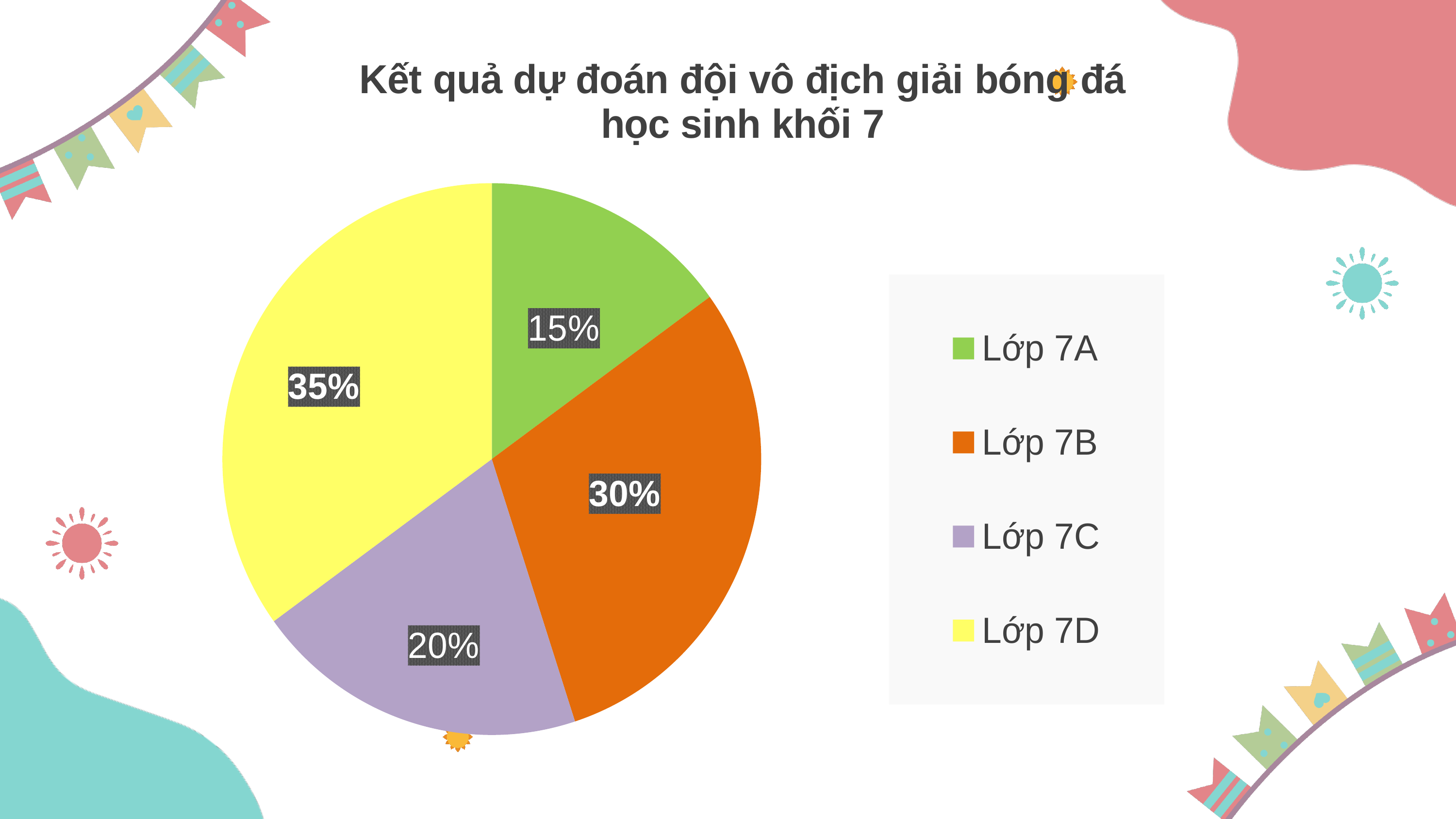
What percentage of the pie is Lớp 7B? 30% How many slices does the pie chart have? 4 Which class has the smallest share of the pie? Lớp 7A Which has a larger share, Lớp 7B or Lớp 7C? Lớp 7B What is the combined share of Lớp 7A and Lớp 7C? 35% What percentage of the pie is Lớp 7D? 35% What colour is the slice for Lớp 7B? orange What percentage of the pie is Lớp 7A? 15% Which class has the largest share of the pie? Lớp 7D What is the difference in percentage points between Lớp 7D and Lớp 7A? 20 What percentage of the pie is Lớp 7C? 20% What type of chart is shown on the slide? pie chart